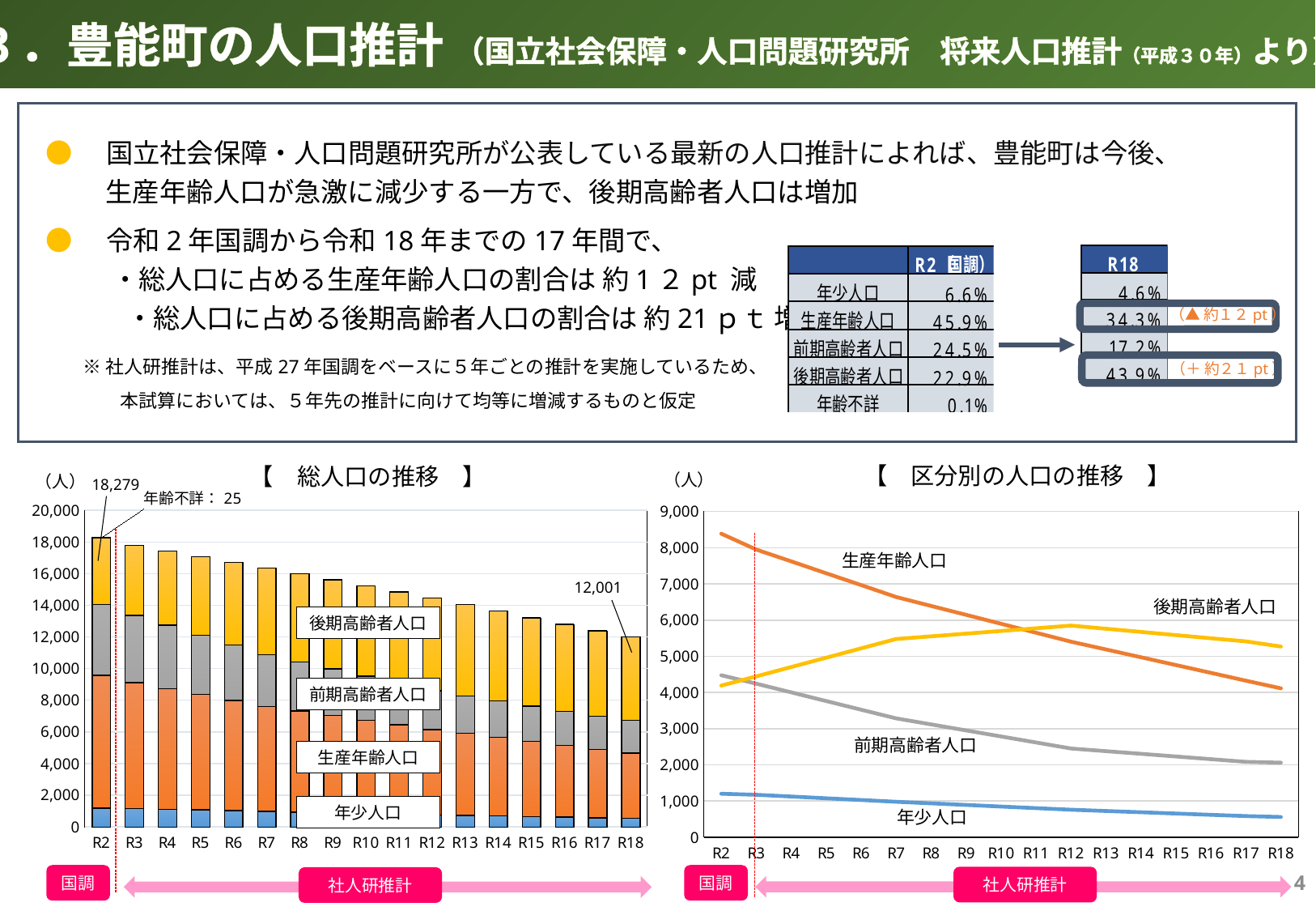
In the left chart (総人口の推移), what is the total population shown for R18? 12,001 In the right chart (区分別の人口の推移), does the 生産年齢人口 line rise or fall from R2 to R18? fall How many years (bars) are shown on the x axis of the left chart (総人口の推移)? 17 In the left chart (総人口の推移), what is the difference between the R2 total (18,279) and the R18 total (12,001)? 6,278 In the right chart (区分別の人口の推移), which category has the highest value at R18? 後期高齢者人口 In the right chart (区分別の人口の推移), is the value for 年少人口 at R2 greater or less than 2,000? less What kind of chart is the right chart titled 区分別の人口の推移? line chart In the left chart (総人口の推移), which year has the highest total population? R2 In the right chart (区分別の人口の推移), which category has the lowest value at R2? 年少人口 In the left chart (総人口の推移), what is the total population shown for R2? 18,279 In the right chart (区分別の人口の推移), is the value for 生産年齢人口 at R2 greater or less than 8,000? greater What kind of chart is the left chart titled 総人口の推移? bar chart